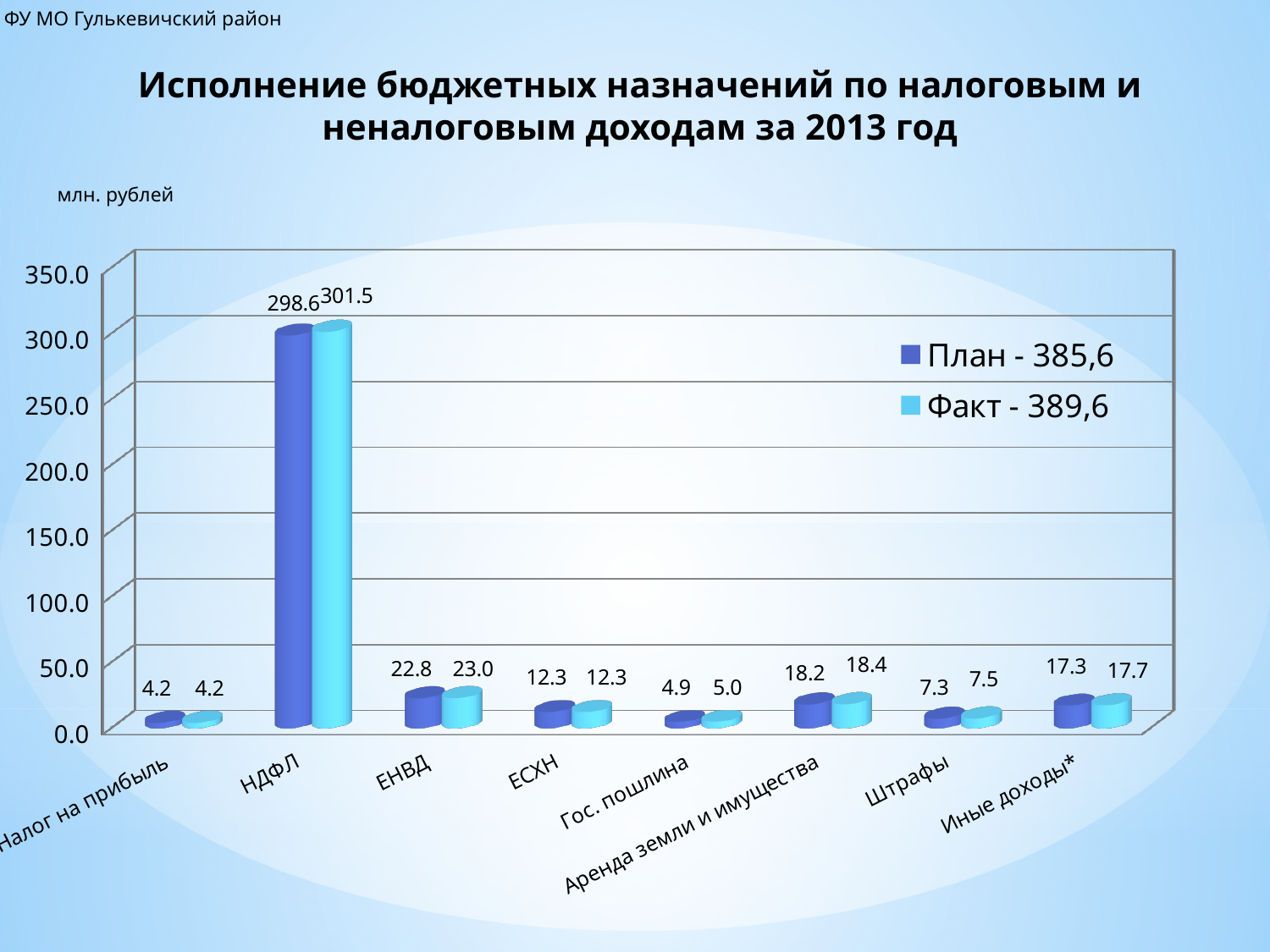
What is the План value for Аренда земли и имущества? 18.2 What is the Факт value for ЕНВД? 23.0 Which category has the highest Факт value? НДФЛ What is the План value for НДФЛ? 298.6 Is the Факт value for НДФЛ greater or less than 300.0? greater Which category has the lowest План value? Налог на прибыль What kind of chart is shown on the slide? Bar chart What is the Факт value for Иные доходы*? 17.7 Which is larger for Штрафы: the План value or the Факт value? Факт What is the difference between the Факт and План values for НДФЛ? 2.9 How many categories are shown on the x axis? 8 How many series does the legend list? 2